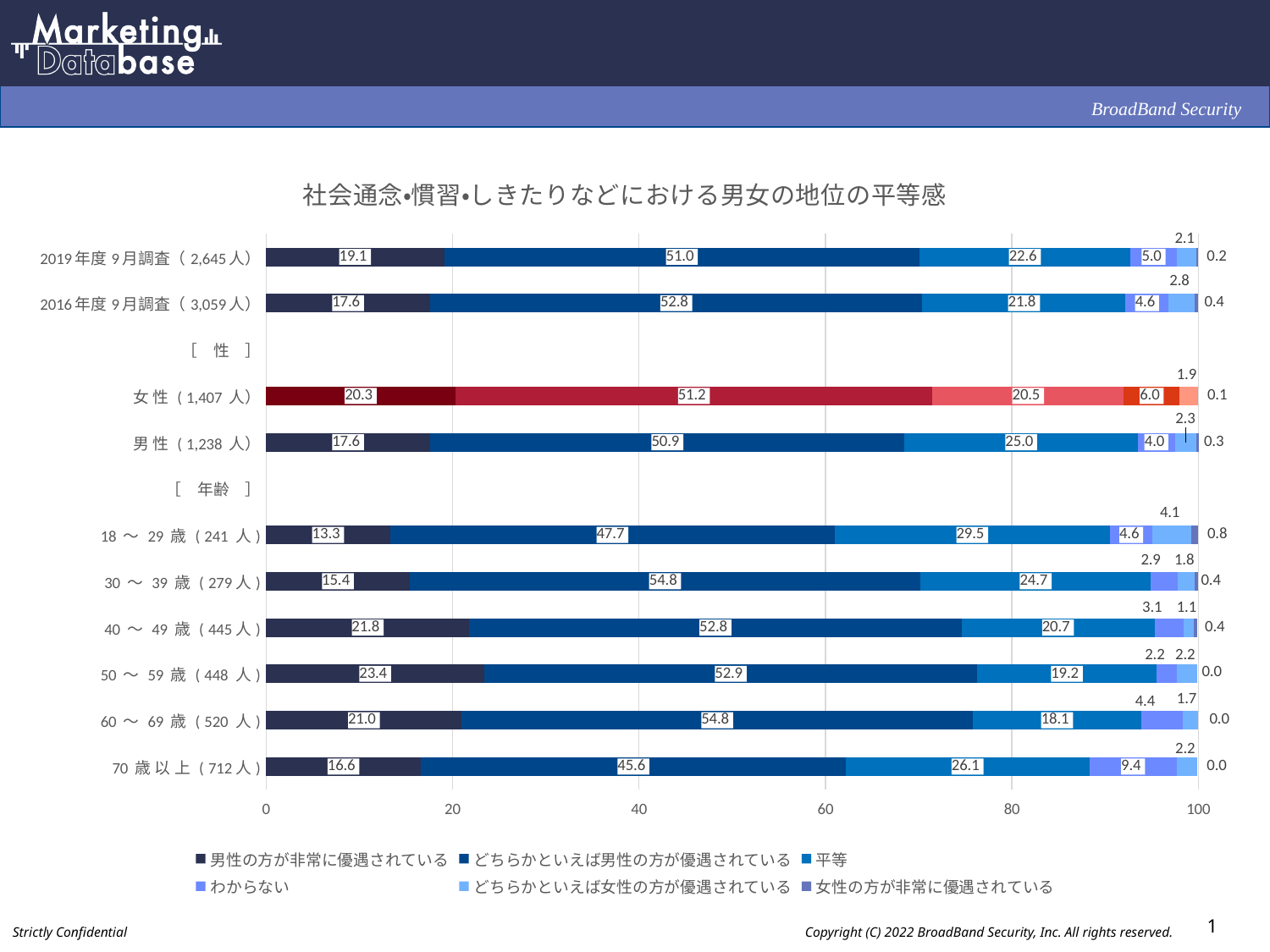
What is the value of 平等 for 70歳以上? 26.1 Which category has the highest value for 男性の方が非常に優遇されている? 50〜59歳 Which category has the lowest value for どちらかといえば男性の方が優遇されている? 70歳以上 What is the value of 男性の方が非常に優遇されている for 2019年度9月調査? 19.1 What is the value of どちらかといえば男性の方が優遇されている for 女性? 51.2 What is the title of the chart? 社会通念•慣習•しきたりなどにおける男女の地位の平等感 Which has a larger value for どちらかといえば男性の方が優遇されている, 18〜29歳 or 70歳以上? 18〜29歳 What is the difference in 平等 between 男性 and 女性? 4.5 Which category has the lowest value for 平等? 60〜69歳 What kind of chart is shown on the slide? Stacked bar chart How many series does the legend list? 6 How many categories (bars) with data are plotted in the chart? 10